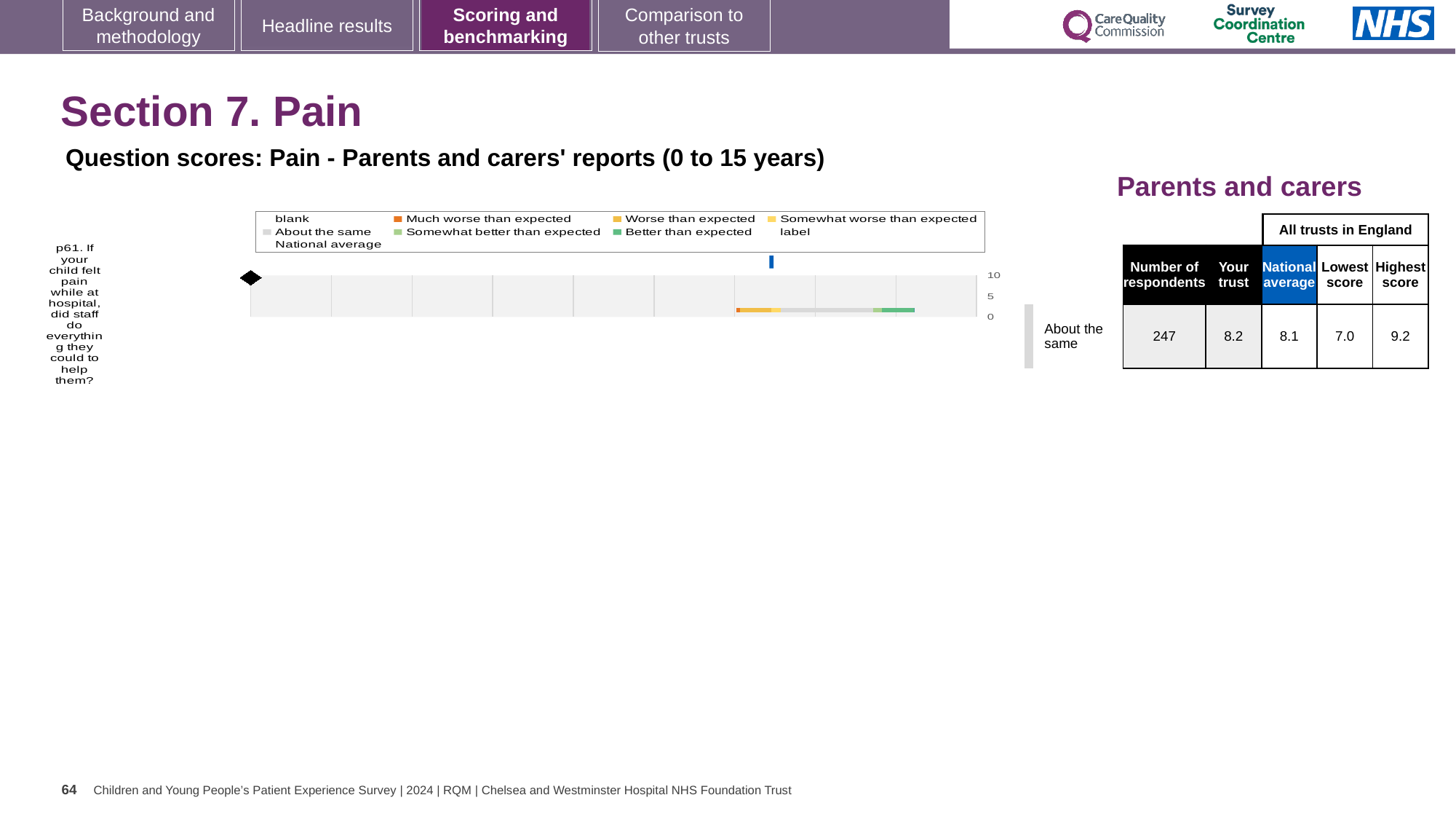
In the table next to the chart, what is the 'Your trust' score for p61? 8.2 In the table next to the chart, what is the difference between the highest score and the lowest score for p61? 2.2 In the table next to the chart, which is larger for p61: the 'Your trust' score or the national average? Your trust In the table next to the chart, what is the national average score for p61? 8.1 What is the highest tick value shown on the chart's score axis? 10 How many entries does the chart legend list? 9 In the table next to the chart, how many respondents answered p61? 247 How many survey questions are plotted in the chart? 1 What colour does the legend use for 'Better than expected'? green What kind of chart is shown on the slide? bar chart Which question is plotted in the chart? p61. If your child felt pain while at hospital, did staff do everything they could to help them? In the table next to the chart, what category is the trust's p61 score placed in? About the same